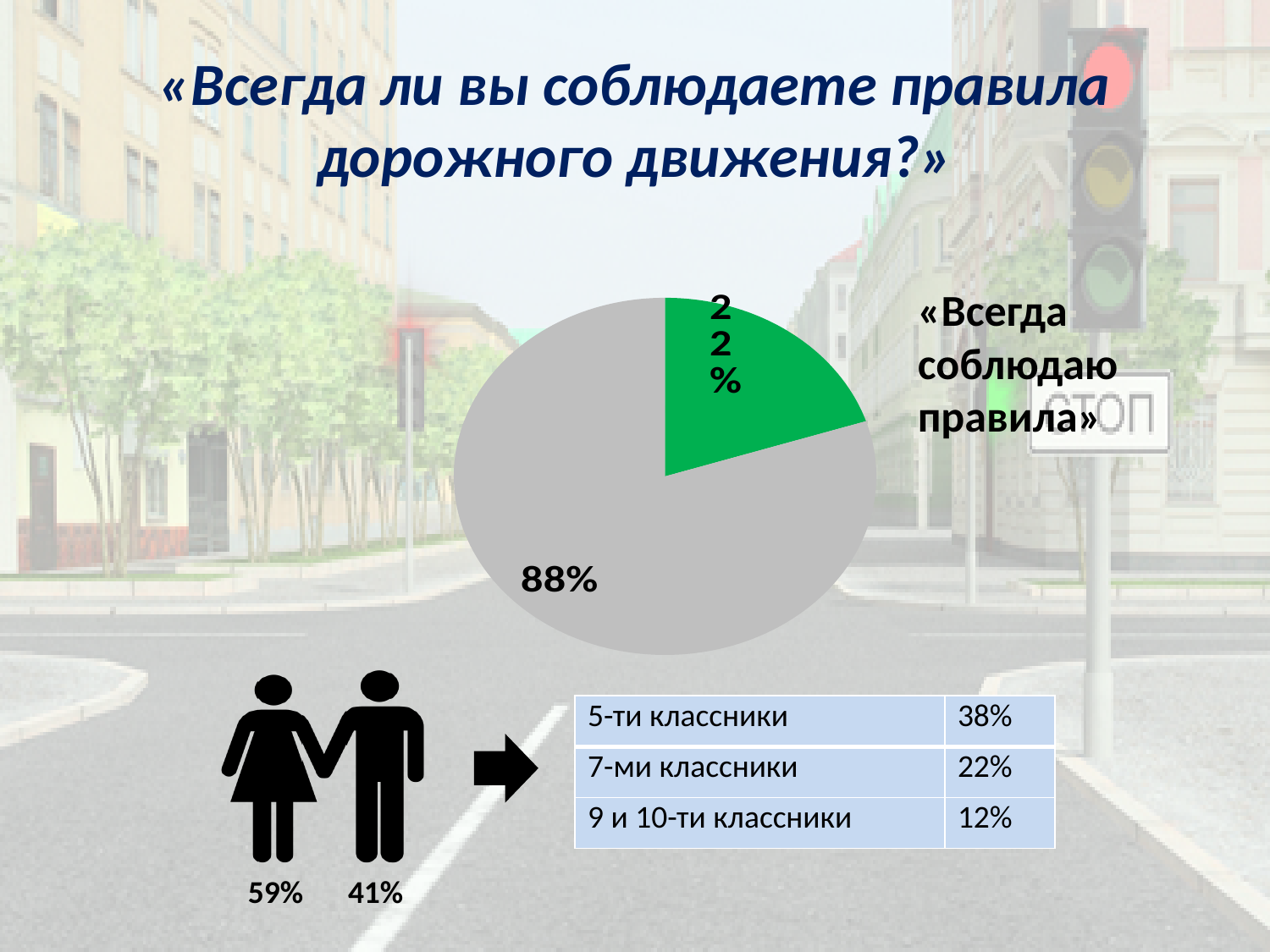
Which slice of the pie chart is larger, the green one or the grey one? the grey one What value is printed on the green slice of the pie chart? 22% What is the difference between the value printed on the grey slice and the value printed on the green slice? 66% What share of the pie does the green slice labelled «Всегда соблюдаю правила» represent? 22% What colour is the slice labelled «Всегда соблюдаю правила»? green What value is printed on the grey slice of the pie chart? 88% Which slice of the pie chart is the smallest? the green slice («Всегда соблюдаю правила») How many slices does the pie chart have? 2 What kind of chart is shown on the slide? pie chart What text label is attached to the green slice of the pie chart? «Всегда соблюдаю правила»